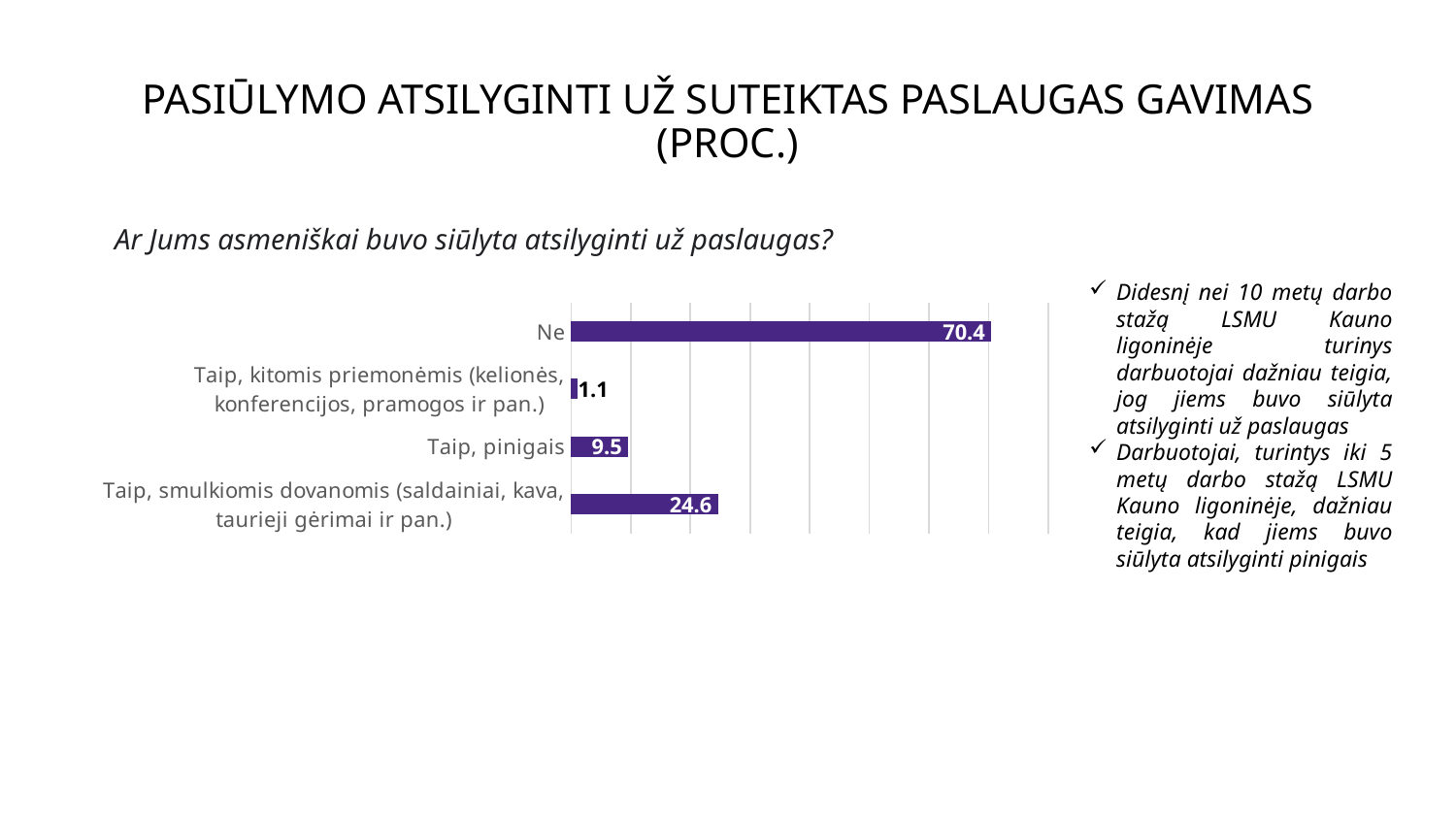
How many categories does the chart show? 4 Which category has the highest value? Ne What is the value for "Ne"? 70.4 Which is larger, the value for "Taip, pinigais" or the value for "Taip, smulkiomis dovanomis (saldainiai, kava, taurieji gėrimai ir pan.)"? Taip, smulkiomis dovanomis (saldainiai, kava, taurieji gėrimai ir pan.) What is the value for "Taip, smulkiomis dovanomis (saldainiai, kava, taurieji gėrimai ir pan.)"? 24.6 What question is written above the chart? Ar Jums asmeniškai buvo siūlyta atsilyginti už paslaugas? Which category has the lowest value? Taip, kitomis priemonėmis (kelionės, konferencijos, pramogos ir pan.) What is the value for "Taip, pinigais"? 9.5 What is the difference between the values for "Taip, smulkiomis dovanomis (saldainiai, kava, taurieji gėrimai ir pan.)" and "Taip, pinigais"? 15.1 What is the difference between the values for "Ne" and "Taip, smulkiomis dovanomis (saldainiai, kava, taurieji gėrimai ir pan.)"? 45.8 What is the value for "Taip, kitomis priemonėmis (kelionės, konferencijos, pramogos ir pan.)"? 1.1 What kind of chart is shown on the slide? Bar chart